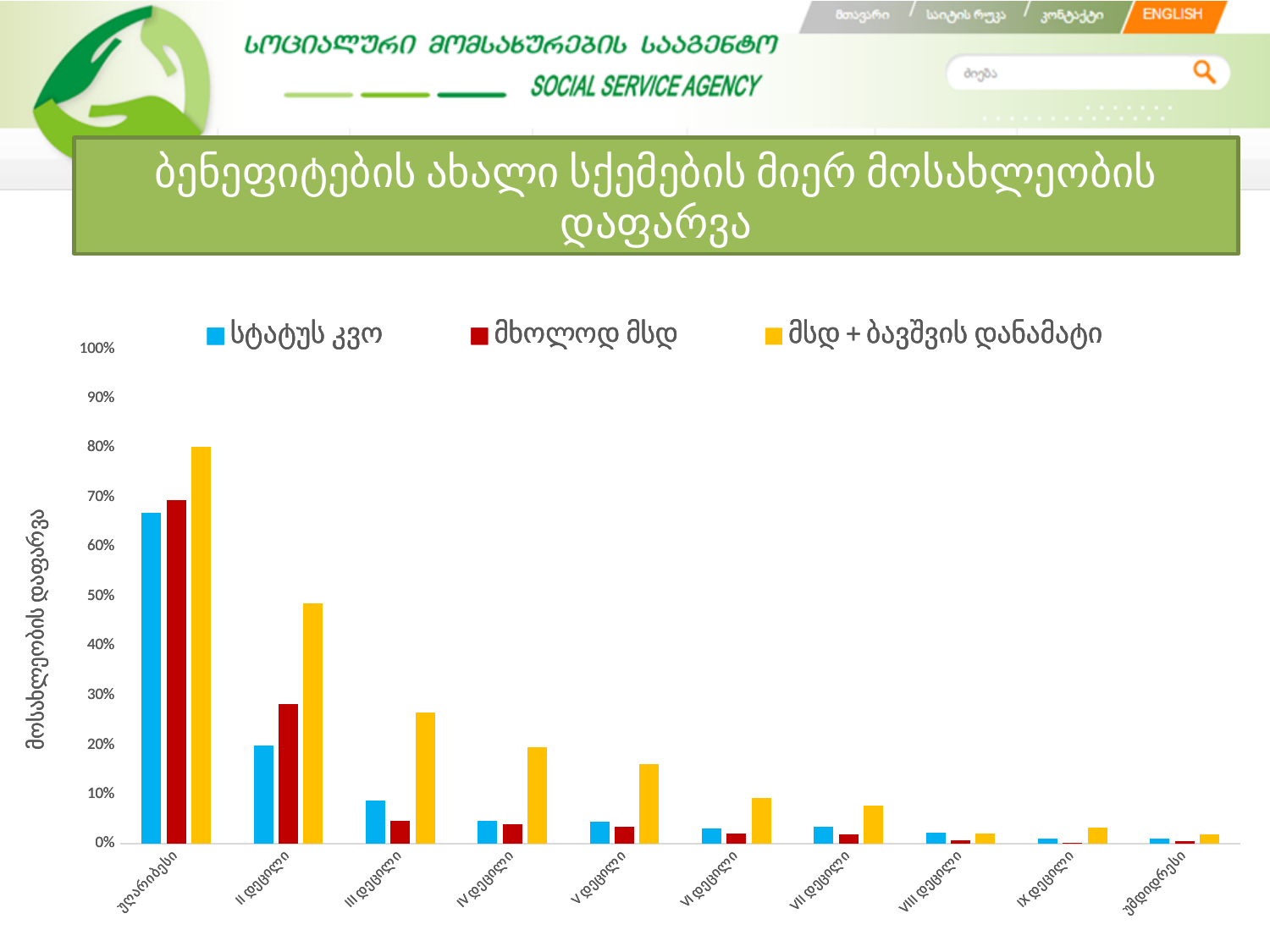
What kind of chart is shown on the slide? bar chart Is the value for მსდ + ბავშვის დანამატი in the category III დეცილი greater or less than 20%? greater Is the value for მსდ + ბავშვის დანამატი in the category II დეცილი greater or less than 40%? greater Which category has the highest value for the series მსდ + ბავშვის დანამატი? უღარიბესი Do the values for მსდ + ბავშვის დანამატი generally rise or fall from უღარიბესი to უმდიდრესი along the x axis? fall How many series does the legend list? 3 In the category უღარიბესი, which is larger: სტატუს კვო or მსდ + ბავშვის დანამატი? მსდ + ბავშვის დანამატი Is the value for მსდ + ბავშვის დანამატი in the category უღარიბესი greater or less than 70%? greater How many categories are shown along the x axis? 10 What colour represents the series მხოლოდ მსდ in the legend? red In the category III დეცილი, which is larger: სტატუს კვო or მხოლოდ მსდ? სტატუს კვო